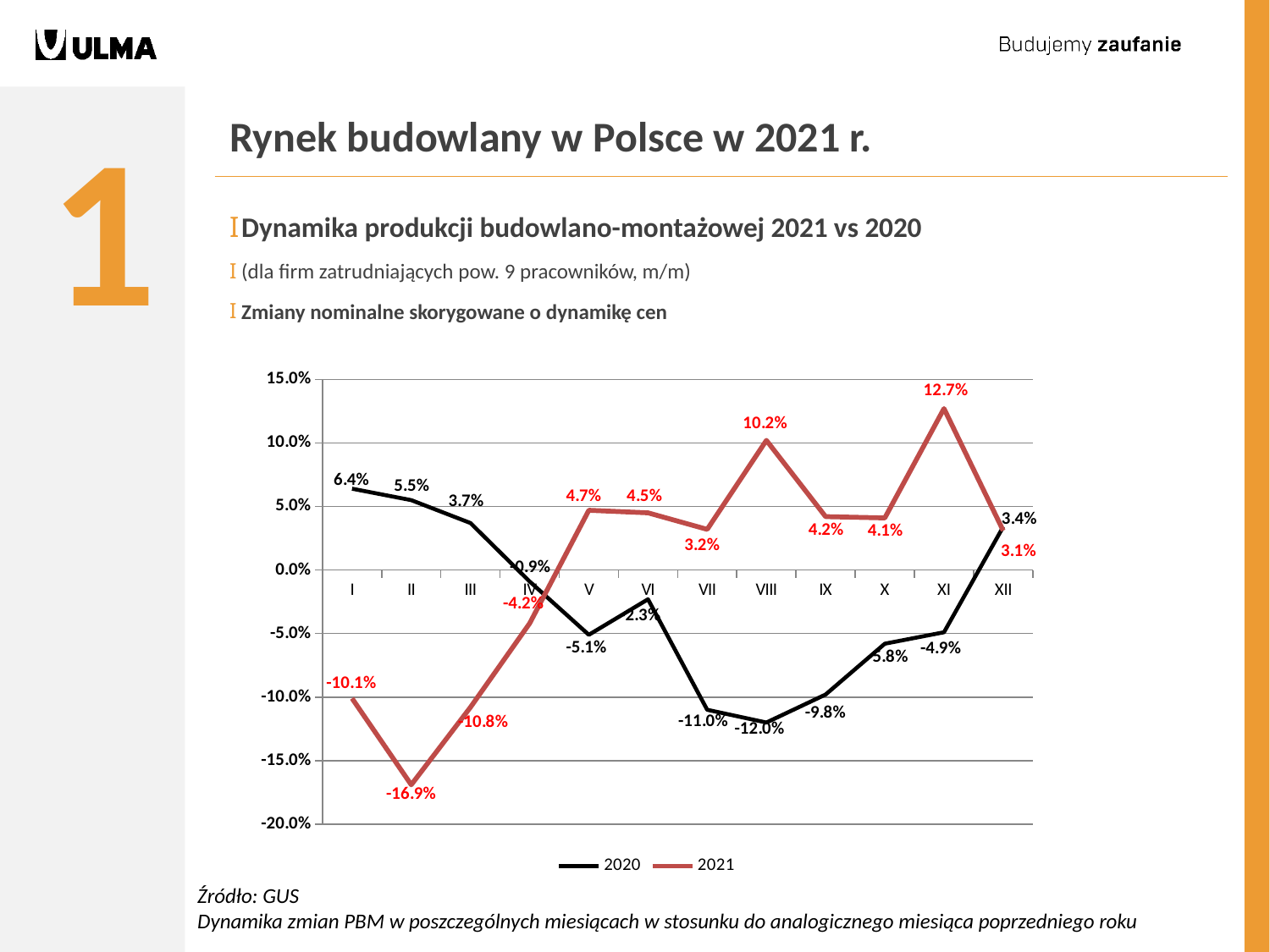
Which series has the larger value in month I, 2020 or 2021? 2020 What is the value for 2020 in month VIII? -12.0% What is the difference between the 2021 and 2020 values in month VIII? 22.2 percentage points How many series does the legend list? 2 Does the 2020 series rise or fall from month I to month III? fall Which colour is used for the 2021 series? red How many months are plotted along the x axis? 12 In which month does the 2020 series reach its lowest value? VIII In which month does the 2021 series reach its highest value? XI What is the value for 2021 in month II? -16.9% What type of chart is shown on the slide? line chart What is the value for 2021 in month XI? 12.7%